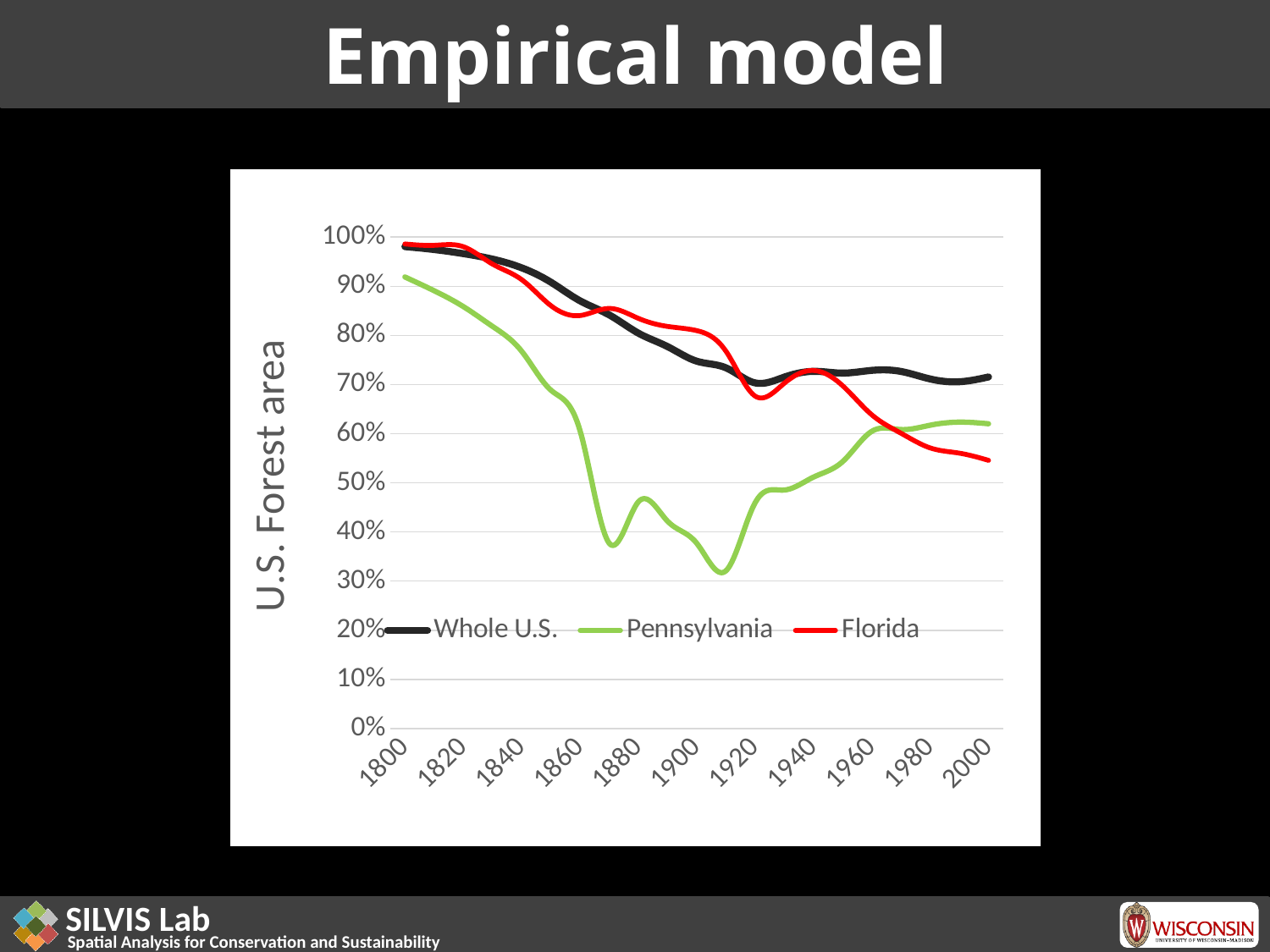
Does the Whole U.S. line rise or fall overall from 1800 to 2000? Fall Is the value for Pennsylvania around 1910 greater or less than 40%? less Which series reaches the lowest value anywhere on the chart? Pennsylvania Is the value for Whole U.S. in 1800 greater or less than 90%? greater What is the label on the vertical axis? U.S. Forest area What kind of chart is shown on the slide? Line chart What are the three series named in the legend? Whole U.S., Pennsylvania, Florida In 1800, which is larger, the value for Whole U.S. or the value for Pennsylvania? Whole U.S. How many series does the legend list? 3 Is the value for Florida in 2000 greater or less than 60%? less In 2000, which is larger, the value for Pennsylvania or the value for Florida? Pennsylvania How many year labels are shown on the x axis? 11